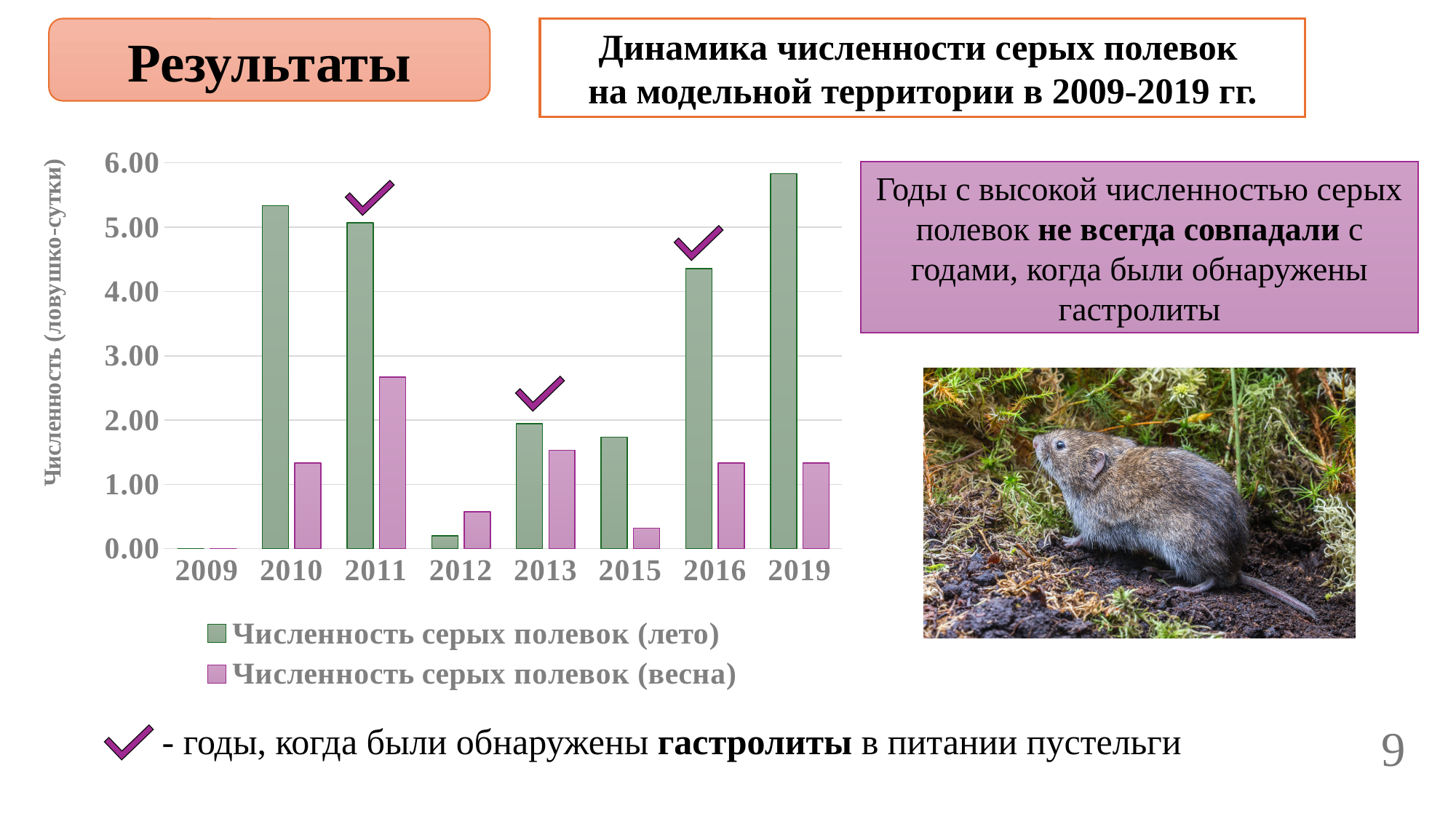
In which year is the spring vole abundance (Численность серых полевок (весна)) highest? 2011 Which series is shown in green in the chart? Численность серых полевок (лето) How many years are shown on the x axis of the chart? 8 Is the summer vole abundance for 2016 greater or less than 4.00? greater Is the summer vole abundance for 2010 greater or less than 5.00? greater In which year is the summer vole abundance (Численность серых полевок (лето)) highest? 2019 Is the spring vole abundance for 2011 greater or less than 2.00? greater How many series does the chart legend list? 2 What kind of chart is shown on the slide? bar chart In 2012, which is larger: the summer or the spring vole abundance? spring In which year is the summer vole abundance lowest? 2009